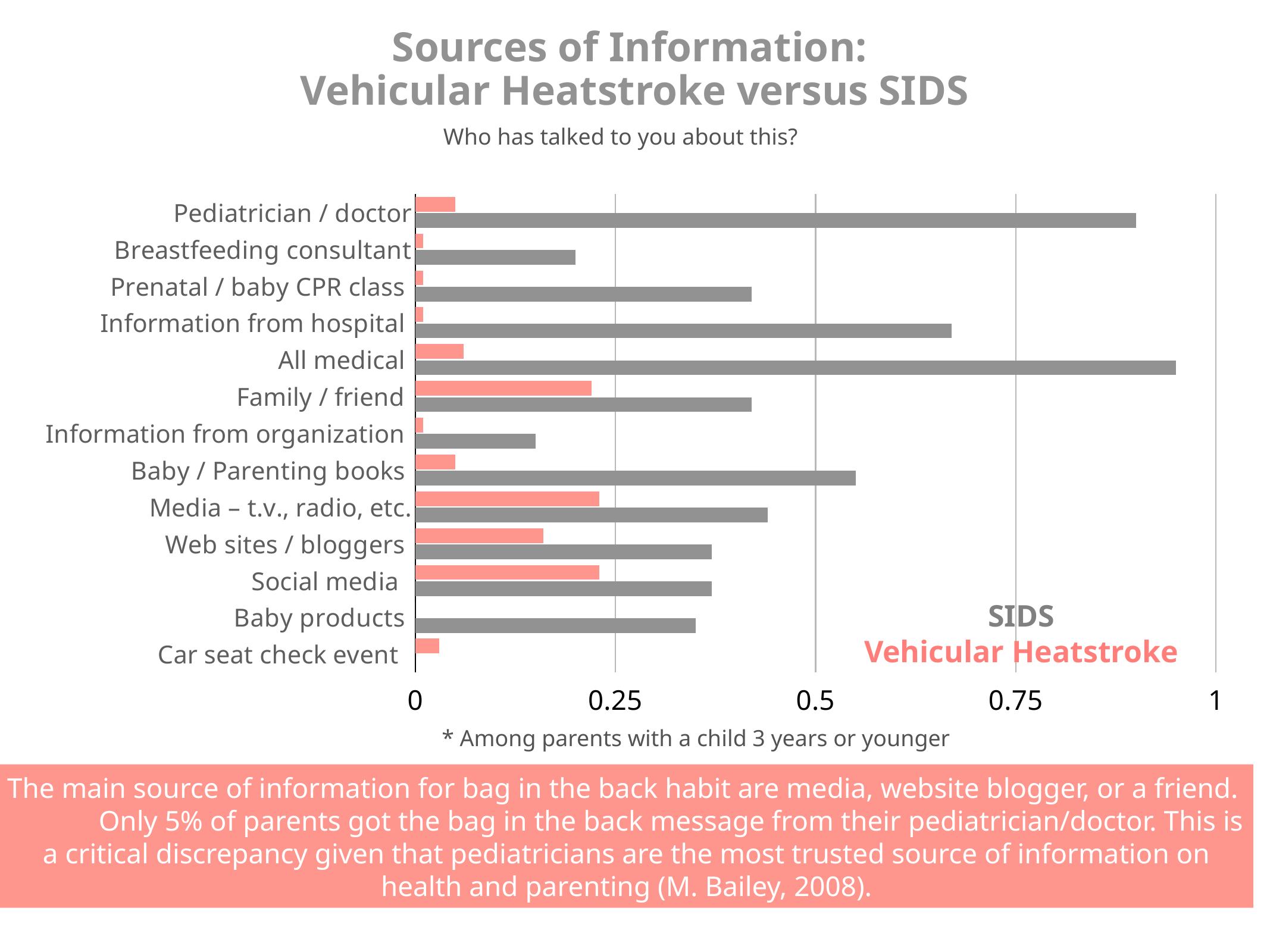
Which category has the lowest SIDS value? Information from organization For Family / friend, which series has the larger value, SIDS or Vehicular Heatstroke? SIDS How many information-source categories are plotted on the chart? 13 Is the Vehicular Heatstroke value for Media – t.v., radio, etc. greater or less than 0.25? less What kind of chart is shown on the slide? Bar chart What colour are the Vehicular Heatstroke bars? Pink How many series does the chart's legend list? 2 Is the SIDS value for Information from hospital greater or less than 0.5? greater Is the SIDS value for Pediatrician / doctor greater or less than 0.75? greater Which category has the lowest Vehicular Heatstroke value? Baby products Which category has the highest SIDS value? All medical Which has the larger Vehicular Heatstroke value, Web sites / bloggers or Social media? Social media